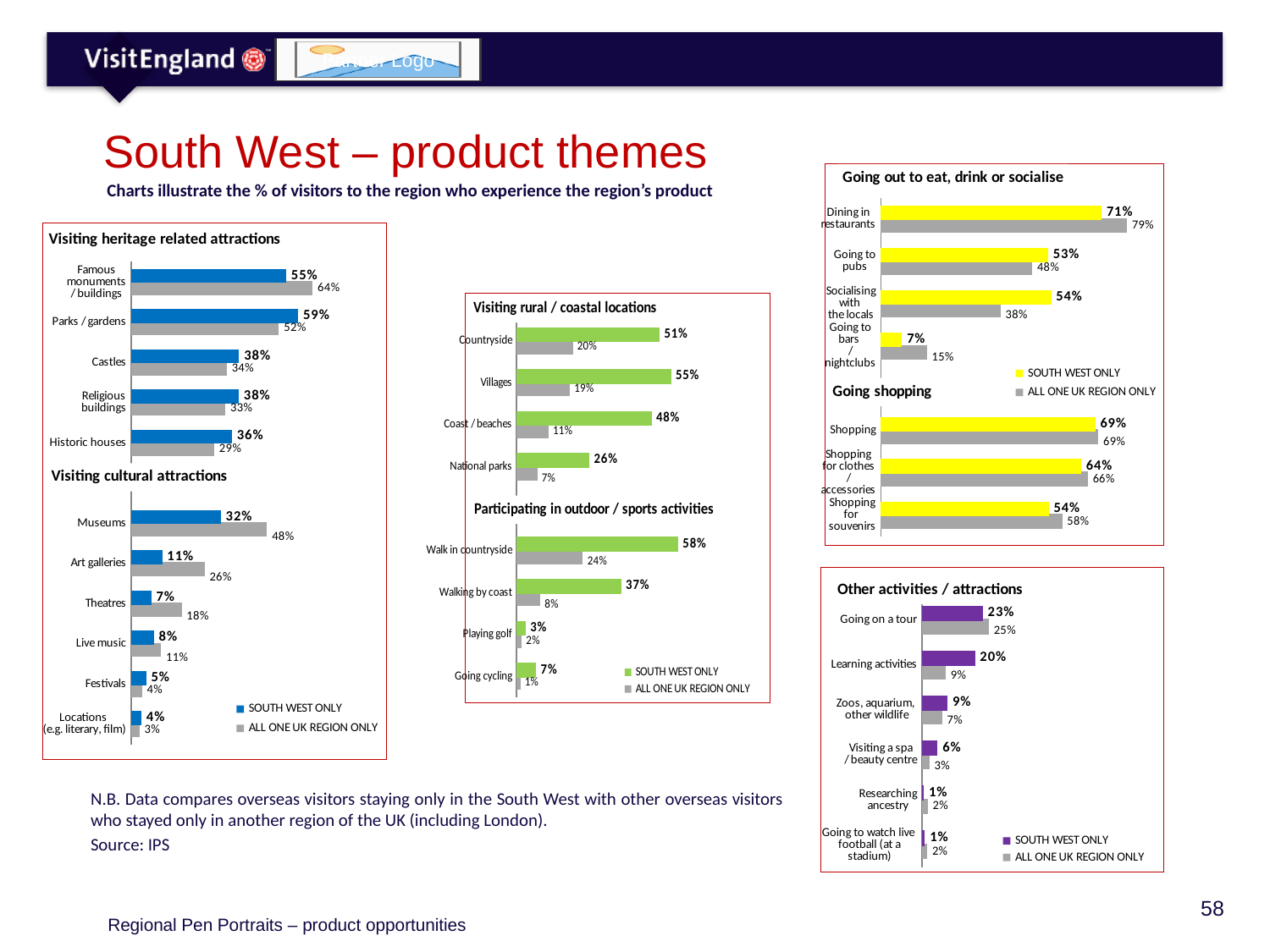
In the 'Going shopping' chart, what is the ALL ONE UK REGION ONLY value for Shopping for souvenirs? 58% In the 'Going out to eat, drink or socialise' chart, what is the SOUTH WEST ONLY value for Going to bars / nightclubs? 7% In the 'Visiting cultural attractions' chart, which category has the highest SOUTH WEST ONLY value? Museums In the 'Visiting rural / coastal locations' chart, which category has the lowest SOUTH WEST ONLY value? National parks How many series does the legend list in the 'Other activities / attractions' chart? 2 In the 'Going out to eat, drink or socialise' chart, which is larger for Dining in restaurants: the SOUTH WEST ONLY value or the ALL ONE UK REGION ONLY value? ALL ONE UK REGION ONLY In the 'Visiting cultural attractions' chart, what is the difference between the ALL ONE UK REGION ONLY and SOUTH WEST ONLY values for Art galleries? 15% In the 'Visiting rural / coastal locations' chart, what is the SOUTH WEST ONLY value for Coast / beaches? 48% In the 'Visiting heritage related attractions' chart, what is the ALL ONE UK REGION ONLY value for Famous monuments / buildings? 64% In the 'Participating in outdoor / sports activities' chart, how many categories are shown? 4 In the 'Other activities / attractions' chart, what is the difference between the SOUTH WEST ONLY and ALL ONE UK REGION ONLY values for Learning activities? 11% In the 'Visiting heritage related attractions' chart, what is the SOUTH WEST ONLY value for Parks / gardens? 59%